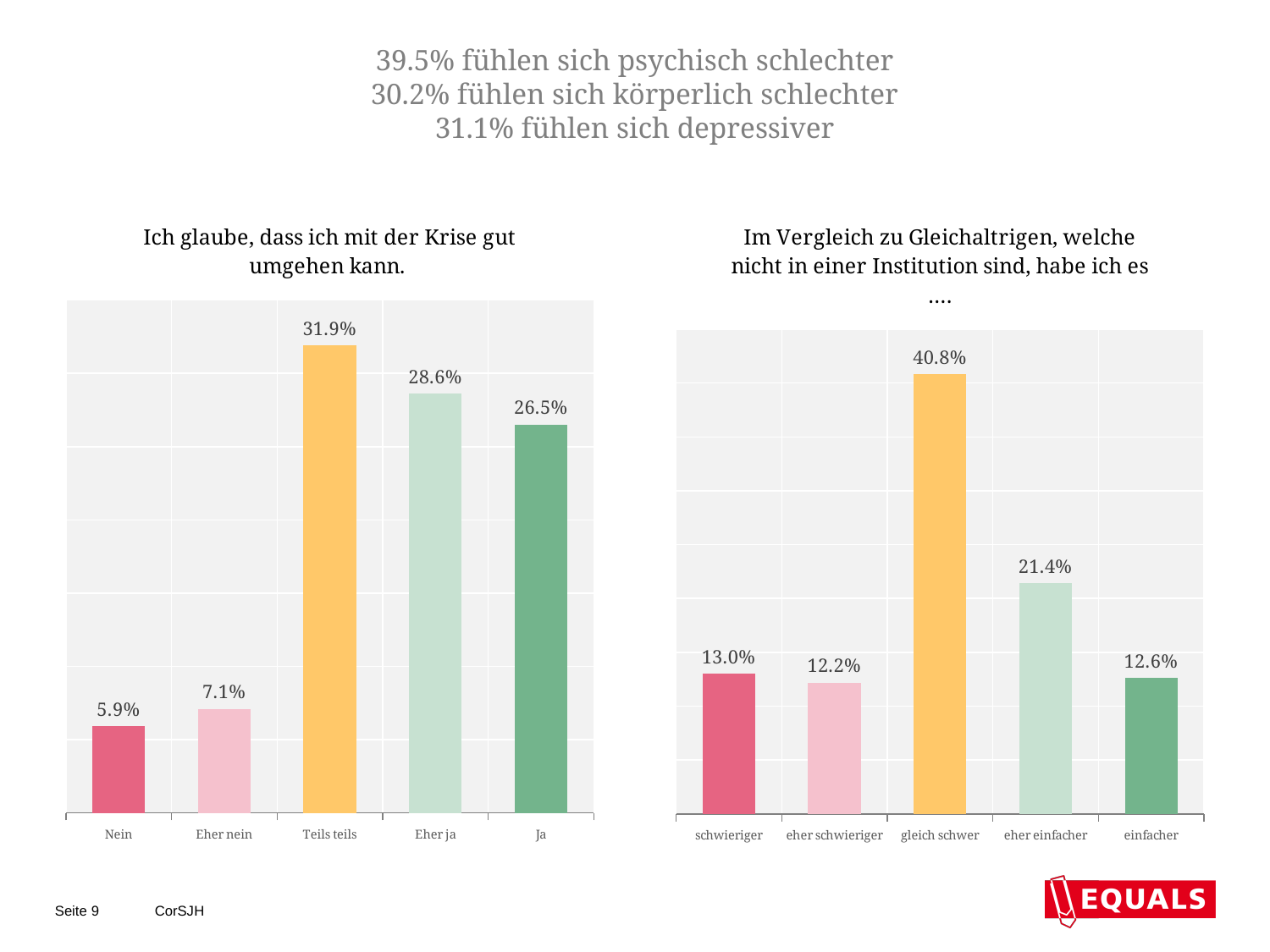
In the right chart 'Im Vergleich zu Gleichaltrigen, welche nicht in einer Institution sind, habe ich es ....', what is the value for 'gleich schwer'? 40.8% In the left chart 'Ich glaube, dass ich mit der Krise gut umgehen kann.', what is the difference between 'Eher ja' and 'Ja'? 2.1% In the left chart 'Ich glaube, dass ich mit der Krise gut umgehen kann.', what is the value for 'Nein'? 5.9% What kind of chart is the right chart 'Im Vergleich zu Gleichaltrigen, welche nicht in einer Institution sind, habe ich es ....'? Bar chart In the left chart 'Ich glaube, dass ich mit der Krise gut umgehen kann.', what is the value for 'Teils teils'? 31.9% In the right chart 'Im Vergleich zu Gleichaltrigen, welche nicht in einer Institution sind, habe ich es ....', what is the value for 'eher einfacher'? 21.4% In the left chart 'Ich glaube, dass ich mit der Krise gut umgehen kann.', how many categories are shown? 5 In the right chart 'Im Vergleich zu Gleichaltrigen, welche nicht in einer Institution sind, habe ich es ....', which category has the highest value? gleich schwer In the right chart 'Im Vergleich zu Gleichaltrigen, welche nicht in einer Institution sind, habe ich es ....', what is the difference between 'gleich schwer' and 'eher einfacher'? 19.4% In the left chart 'Ich glaube, dass ich mit der Krise gut umgehen kann.', which category has the lowest value? Nein In the left chart 'Ich glaube, dass ich mit der Krise gut umgehen kann.', what colour is the 'Teils teils' bar? Yellow/orange In the right chart 'Im Vergleich zu Gleichaltrigen, welche nicht in einer Institution sind, habe ich es ....', which is larger: 'schwieriger' or 'eher schwieriger'? schwieriger